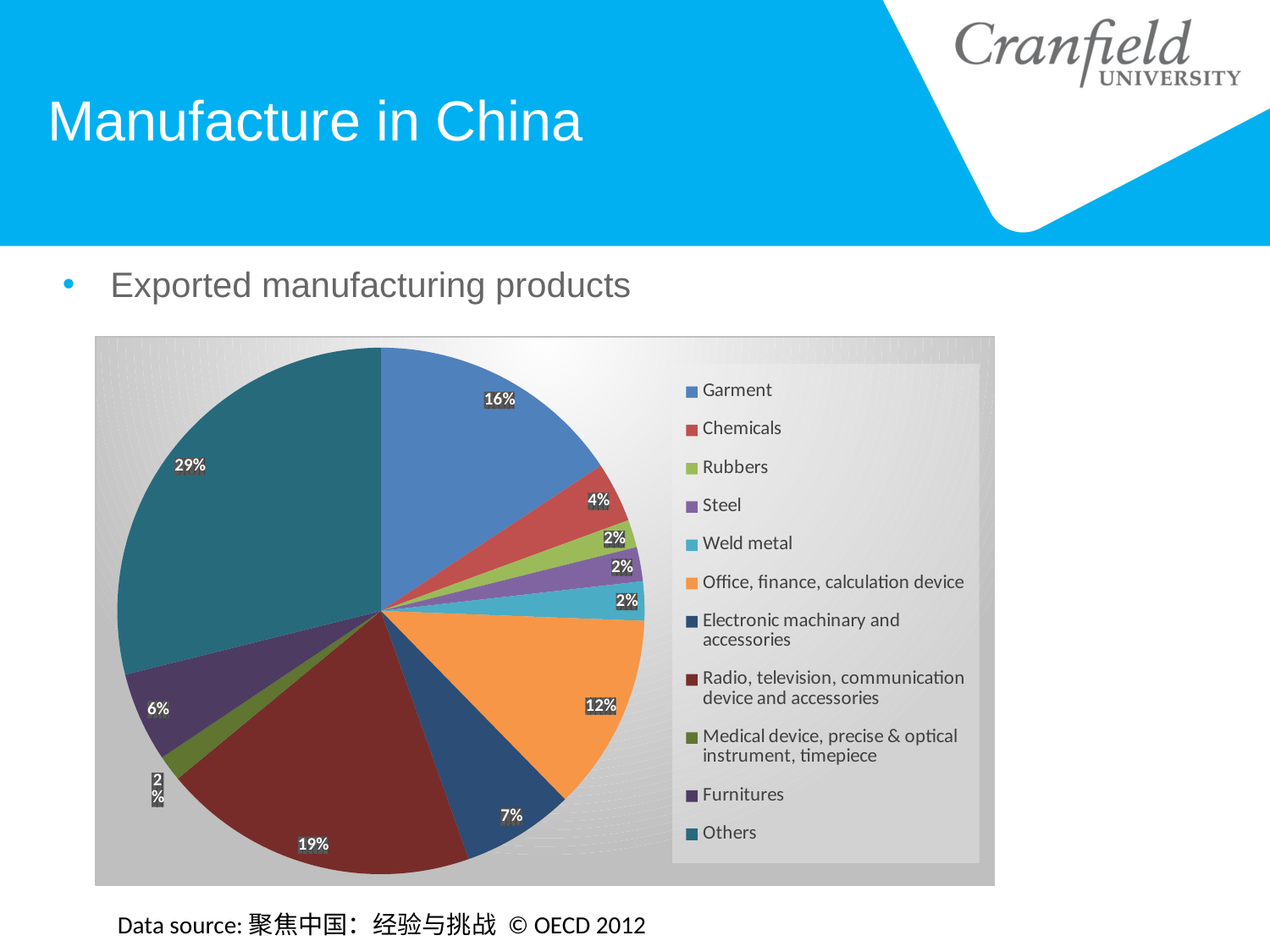
What share of the pie is Chemicals? 4% Which is larger, the share for Garment or the share for Electronic machinary and accessories? Garment What kind of chart is shown on the slide? pie chart Which category has the largest share of the pie? Others What is the difference between the share for Others and the share for Radio, television, communication device and accessories? 10% What share of the pie is Radio, television, communication device and accessories? 19% How many categories does the legend list? 11 What share of exported manufacturing products is Garment? 16% What share of the pie is Office, finance, calculation device? 12% What colour is the Others slice in the legend? dark teal What share of the pie is Others? 29% What share of the pie is Furnitures? 6%